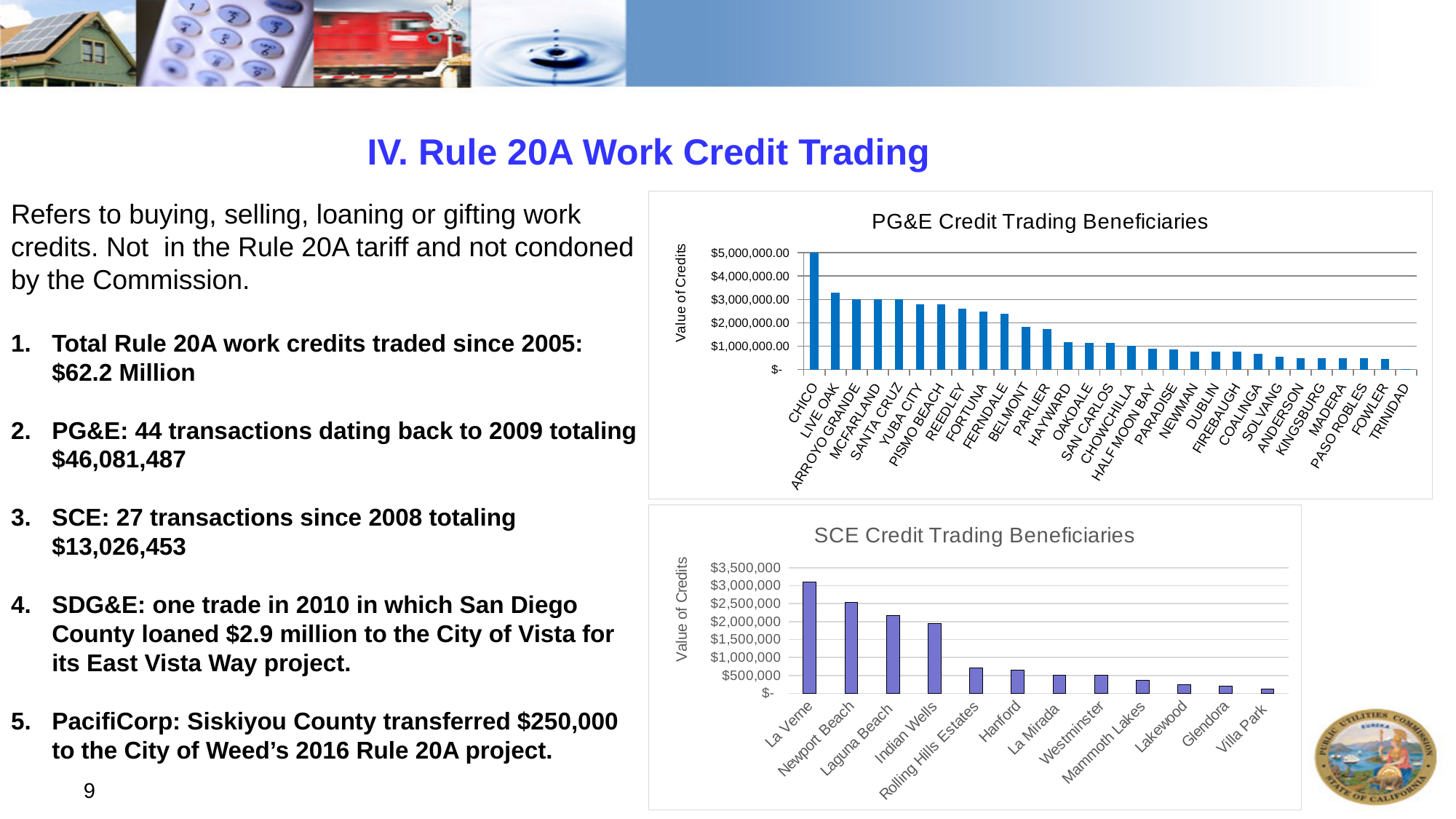
In the SCE Credit Trading Beneficiaries chart, which has a larger value, Hanford or Indian Wells? Indian Wells In the SCE Credit Trading Beneficiaries chart, which city has the highest value of credits? La Verne In the PG&E Credit Trading Beneficiaries chart, which has a larger value, CHICO or LIVE OAK? CHICO What is the y-axis label of the SCE Credit Trading Beneficiaries chart? Value of Credits How many cities are shown in the SCE Credit Trading Beneficiaries chart? 12 In the PG&E Credit Trading Beneficiaries chart, is the value for LIVE OAK greater or less than $3,000,000.00? greater What type of chart is the PG&E Credit Trading Beneficiaries chart? bar chart In the PG&E Credit Trading Beneficiaries chart, which city has the highest value of credits? CHICO In the SCE Credit Trading Beneficiaries chart, is the value for Laguna Beach greater or less than $2,000,000? greater In the SCE Credit Trading Beneficiaries chart, which city has the lowest value of credits? Villa Park In the PG&E Credit Trading Beneficiaries chart, is the value for TRINIDAD greater or less than $1,000,000.00? less In the PG&E Credit Trading Beneficiaries chart, do the values rise or fall moving from left to right along the x axis? fall